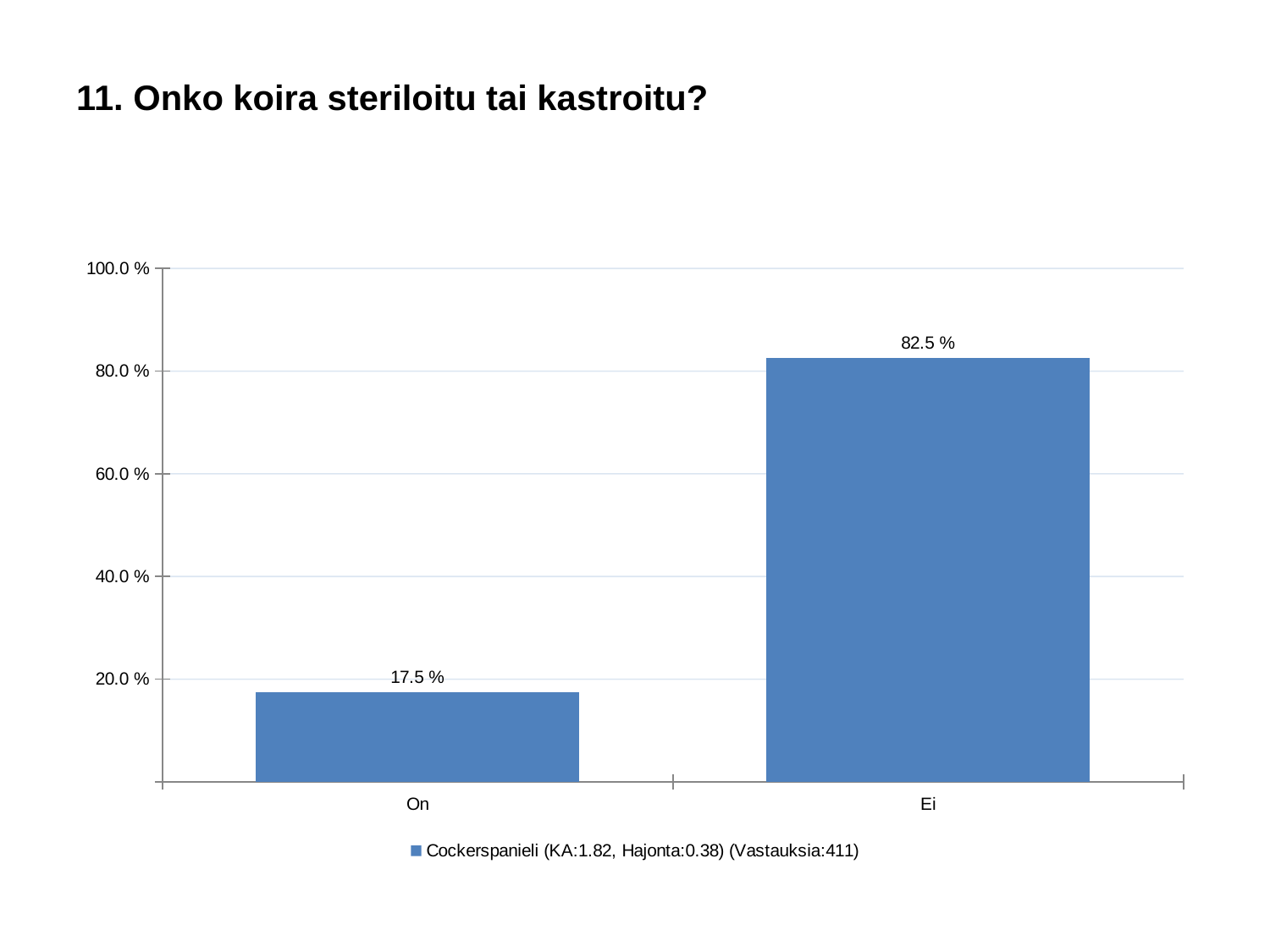
Is the value for "On" greater or less than 20.0 %? less Is the value for "Ei" greater or less than 80.0 %? greater How many series does the legend list? 1 What is the value for "On"? 17.5 % Which category has the lowest value? On Which is larger, the value for "On" or the value for "Ei"? Ei How many categories are shown on the x axis? 2 What kind of chart is shown on the slide? bar chart What is the difference between the values for "Ei" and "On"? 65.0 % What is the title of the slide? 11. Onko koira steriloitu tai kastroitu? What is the value for "Ei"? 82.5 % Which category has the highest value? Ei